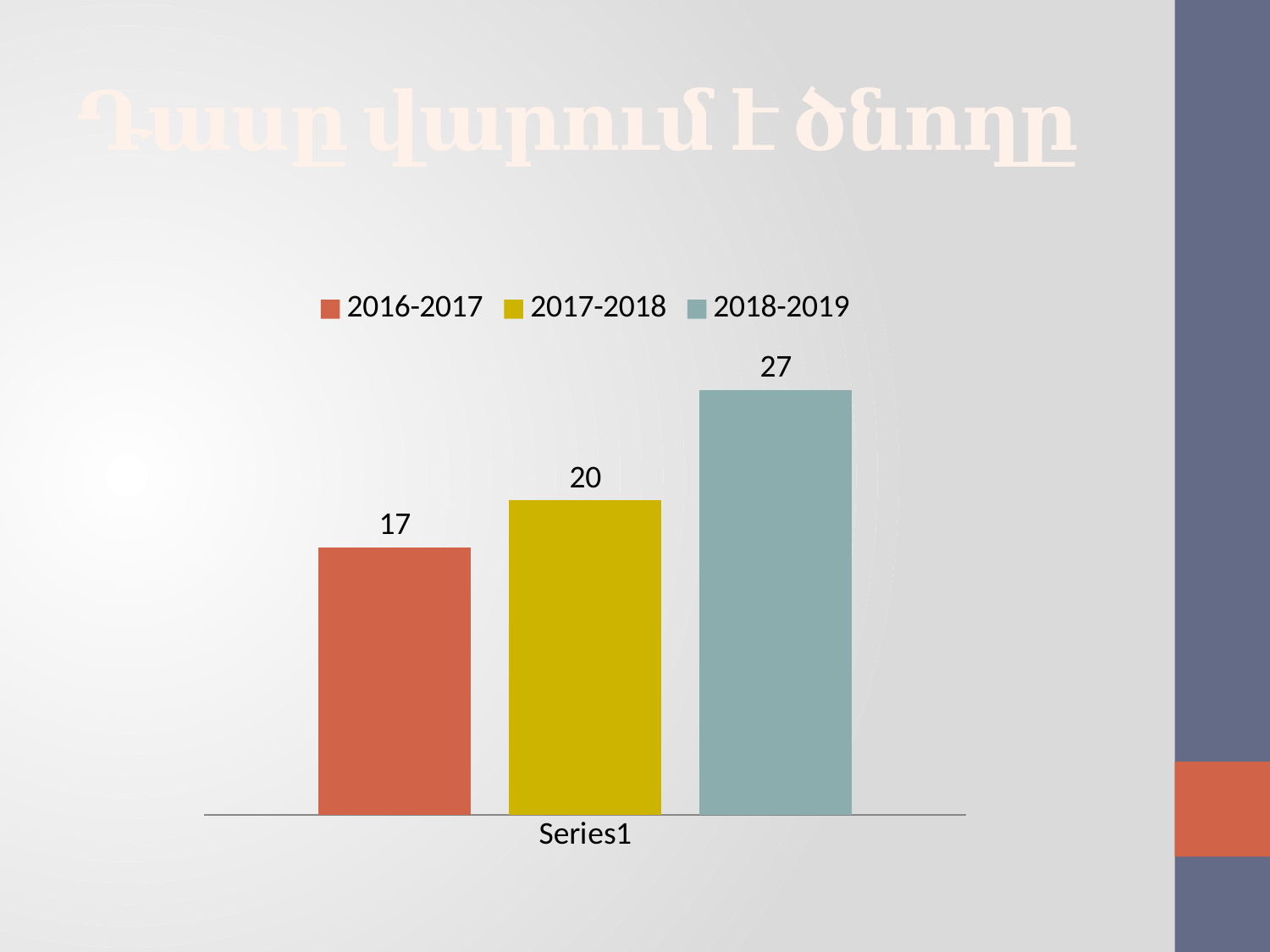
What kind of chart is shown on the slide? bar chart What is the difference between the values for 2018-2019 and 2016-2017? 10 Which series has the highest value? 2018-2019 Do the values rise or fall from 2016-2017 to 2018-2019? rise Which series has the lowest value? 2016-2017 What is the value for 2017-2018? 20 What is the difference between the values for 2017-2018 and 2016-2017? 3 What is the category label shown on the x axis? Series1 How many series does the legend list? 3 What is the value for 2016-2017? 17 Which is larger, the value for 2017-2018 or the value for 2018-2019? 2018-2019 What is the value for 2018-2019? 27